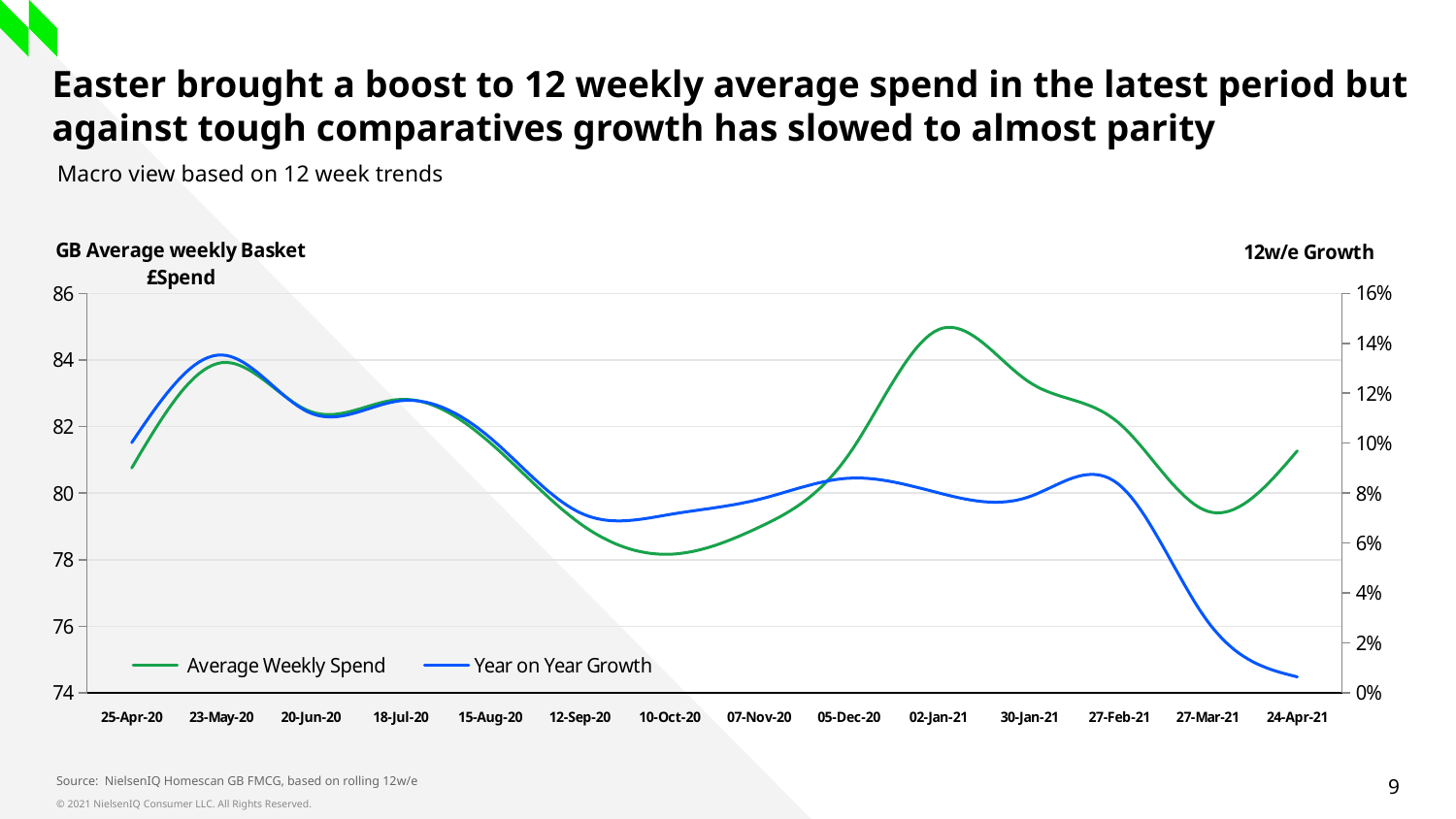
What is the title of the right-hand axis of the chart? 12w/e Growth At which date does the Year on Year Growth line reach its highest point? 23-May-20 How many series does the chart legend list? 2 At which date does the Average Weekly Spend line reach its lowest point? 10-Oct-20 Is the Year on Year Growth value at 24-Apr-21 greater or less than 2%? less What kind of chart is shown on the slide? line chart At which date does the Average Weekly Spend line reach its highest point? 02-Jan-21 Is the Average Weekly Spend value at 10-Oct-20 greater or less than 80? less Does the Year on Year Growth line rise or fall between 27-Feb-21 and 24-Apr-21? fall Is the Average Weekly Spend value at 02-Jan-21 greater or less than 84? greater At which date does the Year on Year Growth line reach its lowest point? 24-Apr-21 How many date labels are shown along the x axis of the chart? 14